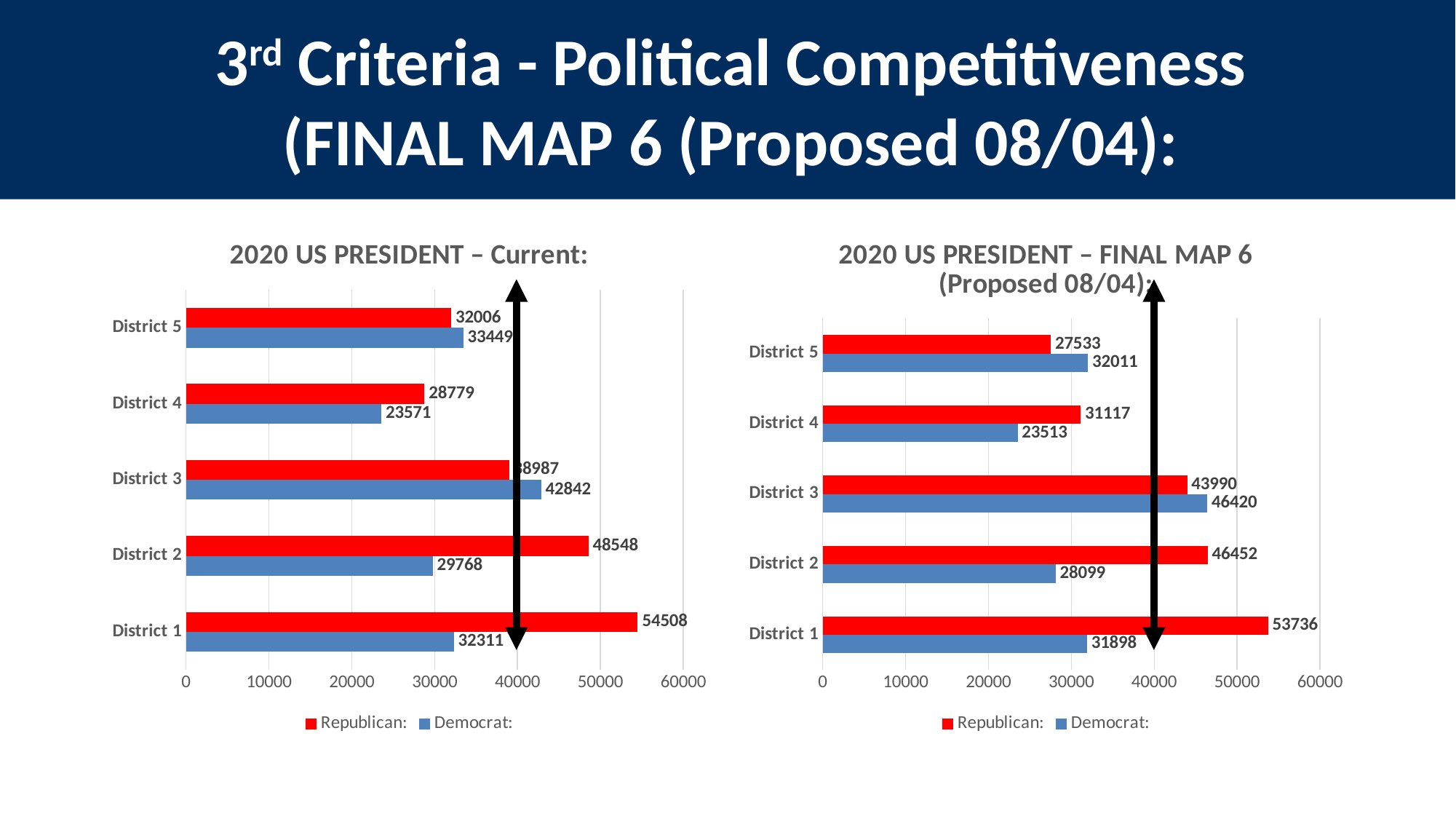
How many districts are shown in the '2020 US PRESIDENT – Current:' chart? 5 In the '2020 US PRESIDENT – FINAL MAP 6 (Proposed 08/04):' chart, which district has the lowest Democrat value? District 4 In the '2020 US PRESIDENT – Current:' chart, what is the Democrat value for District 5? 33449 How many series does the legend of the '2020 US PRESIDENT – FINAL MAP 6 (Proposed 08/04):' chart list? 2 In the '2020 US PRESIDENT – Current:' chart, what is the difference between the Republican and Democrat values for District 2? 18780 In the '2020 US PRESIDENT – Current:' chart, which district has the highest Republican value? District 1 What type of chart is the '2020 US PRESIDENT – Current:' chart? Bar chart In the '2020 US PRESIDENT – FINAL MAP 6 (Proposed 08/04):' chart, what is the difference between the Republican and Democrat values for District 1? 21838 In the '2020 US PRESIDENT – Current:' chart, what is the Republican value for District 1? 54508 In the '2020 US PRESIDENT – FINAL MAP 6 (Proposed 08/04):' chart, what is the Democrat value for District 3? 46420 In the '2020 US PRESIDENT – FINAL MAP 6 (Proposed 08/04):' chart, which is larger for District 5, the Republican value or the Democrat value? Democrat In the '2020 US PRESIDENT – FINAL MAP 6 (Proposed 08/04):' chart, what is the Republican value for District 2? 46452